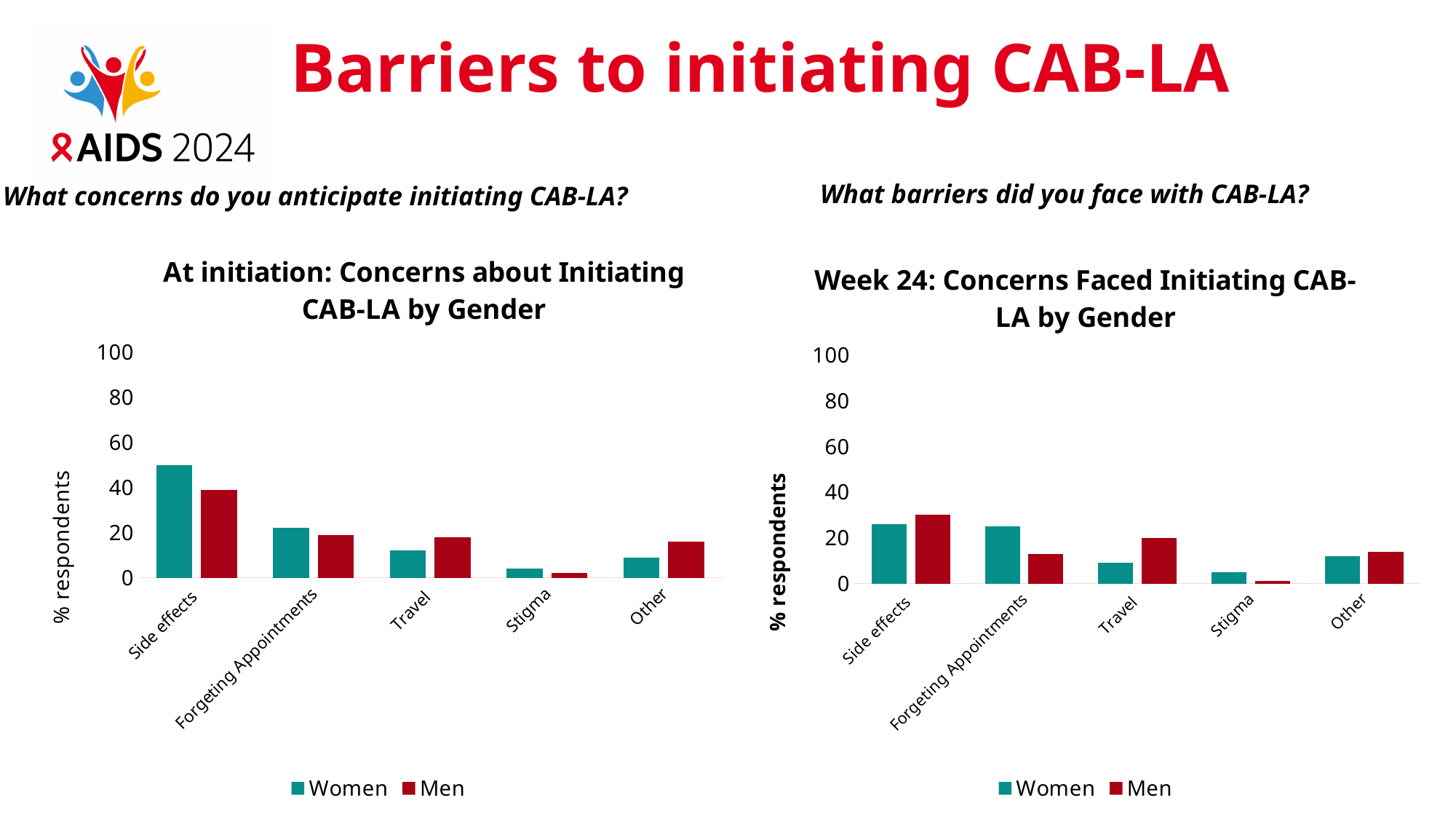
In the 'At initiation' chart, which category has the lowest value for Men? Stigma What is the y-axis label on the 'Week 24' chart? % respondents What kind of chart is the 'At initiation: Concerns about Initiating CAB-LA by Gender' chart? bar chart In the 'Week 24' chart, for Forgeting Appointments, which is larger: Women or Men? Women In the 'At initiation' chart, which category has the highest value for Women? Side effects In the 'Week 24' chart, which category has the lowest value for Men? Stigma In the 'At initiation' chart, how many series does the legend list? 2 In the 'At initiation' chart, is the value for Women for Side effects greater or less than 40? greater In the 'At initiation' chart, how many concern categories are shown on the x axis? 5 In the 'Week 24' chart, is the value for Men for Travel greater or less than 10? greater In the 'Week 24' chart, is the value for Men for Side effects greater or less than 20? greater In the 'At initiation' chart, for Travel, which is larger: Women or Men? Men